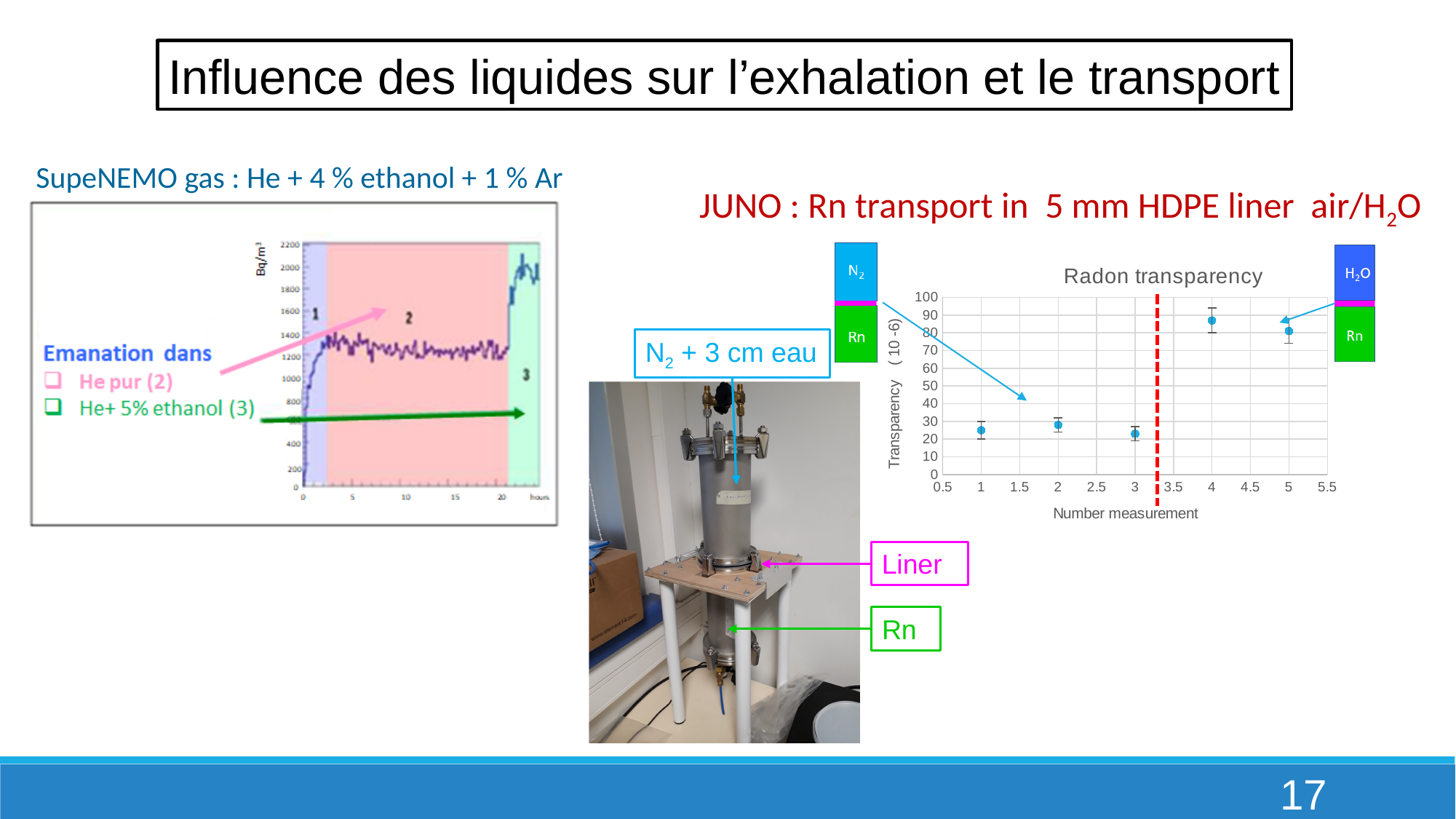
In the Radon transparency chart, is the value for measurement 3 greater or less than 30? less In the Radon transparency chart, which measurement number has the highest transparency value? 4 What is the title of the chart on the right of the slide? Radon transparency What kind of chart is the Radon transparency chart? Scatter chart In the Radon transparency chart, is the value for measurement 1 greater or less than 30? less In the Radon transparency chart, is the value for measurement 4 greater or less than 80? greater In the Radon transparency chart, what is the maximum value shown on the y axis? 100 In the Radon transparency chart, which has the larger value: measurement 2 or measurement 4? Measurement 4 In the Radon transparency chart, what is the label of the x axis? Number measurement How many data points are plotted in the Radon transparency chart? 5